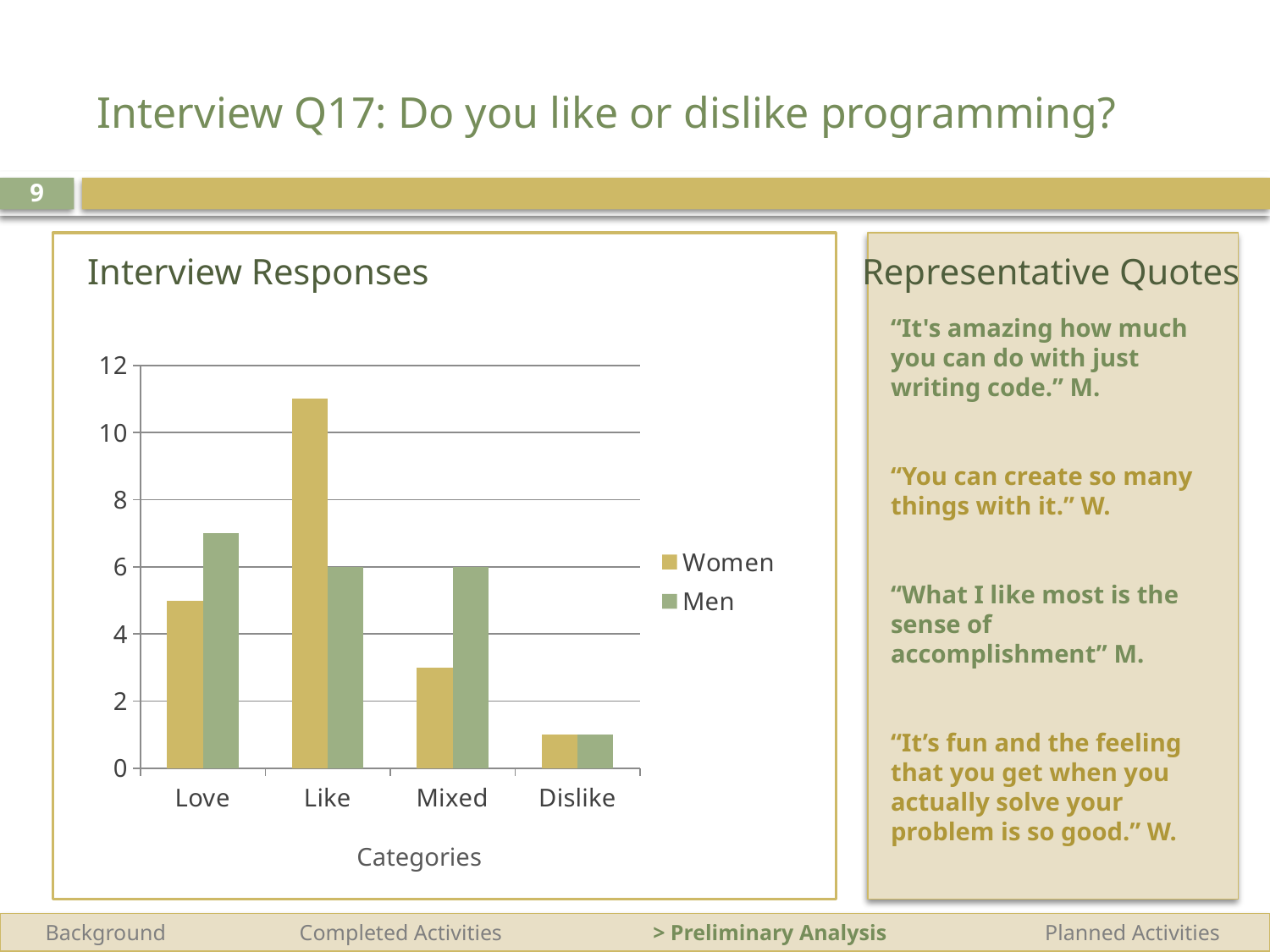
How many series does the chart's legend list? 2 In the Love category, which is larger, the value for Women or the value for Men? Men What kind of chart is shown on the slide? bar chart How many categories are shown on the x axis of the chart? 4 Is the value for Women in the Mixed category greater or less than 4? less Which category has the highest value for Women? Like Is the value for Women in the Like category greater or less than 10? greater What is the title of the chart? Interview Responses What is the value for Men in the Mixed category? 6 Which category has the highest value for Men? Love What is the value for Men in the Like category? 6 Which category has the lowest value for Women? Dislike